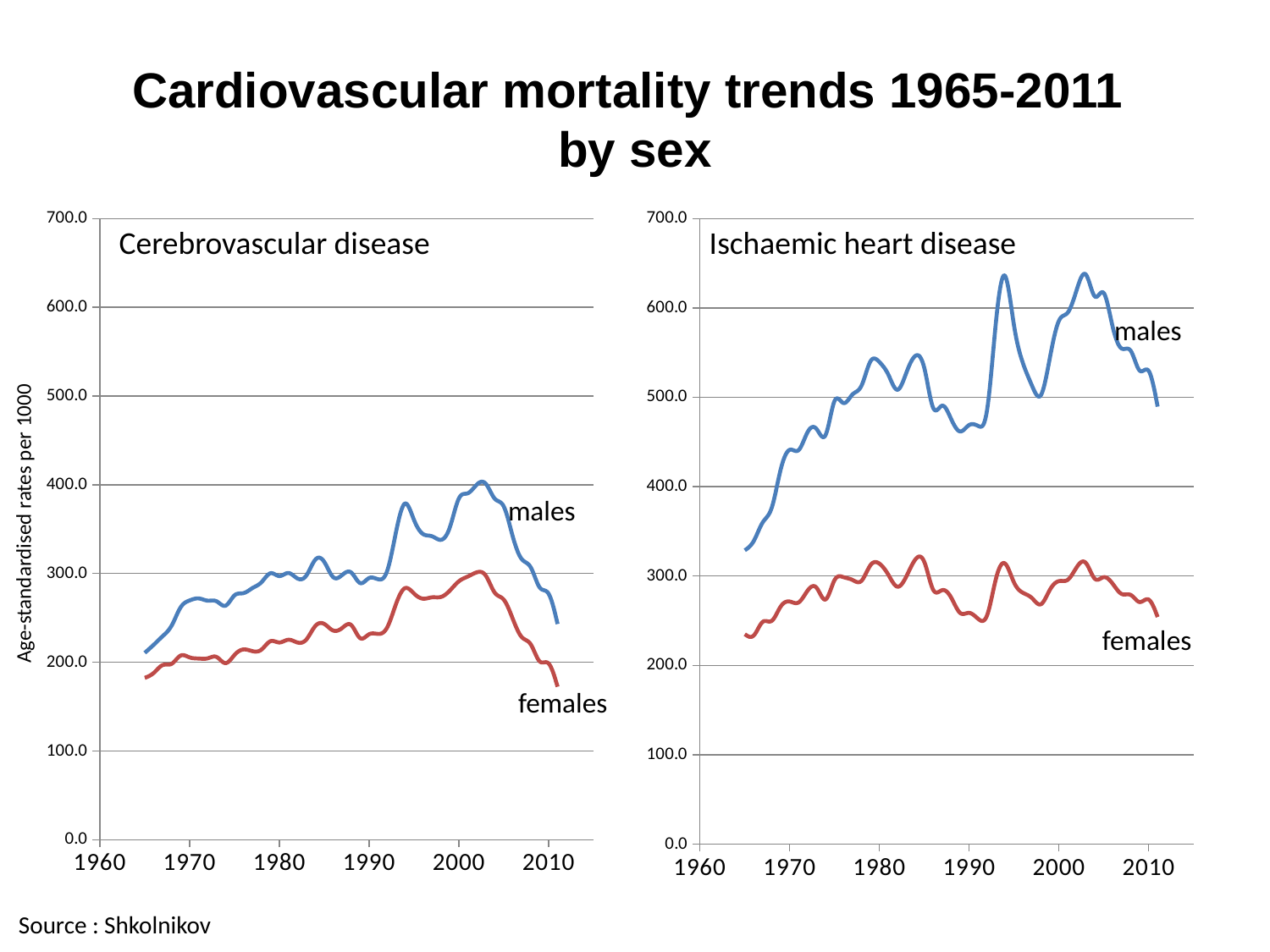
In the Cerebrovascular disease chart, do the male values rise or fall between 2003 and 2011? fall In the Ischaemic heart disease chart, do the male values rise or fall between 1965 and 1980? rise In the Ischaemic heart disease chart, is the value for females in 2010 greater or less than 200? greater In the Cerebrovascular disease chart, is the peak value for males greater or less than 300? greater In the Ischaemic heart disease chart, is the peak value for males greater or less than 600? greater What is the y-axis label on the Cerebrovascular disease chart? Age-standardised rates per 1000 Which chart shows the higher peak value for males, Cerebrovascular disease or Ischaemic heart disease? Ischaemic heart disease In the Ischaemic heart disease chart, which series has the higher values throughout, males or females? males How many series are plotted in the Ischaemic heart disease chart? 2 What kind of chart is used for the Cerebrovascular disease panel? line chart